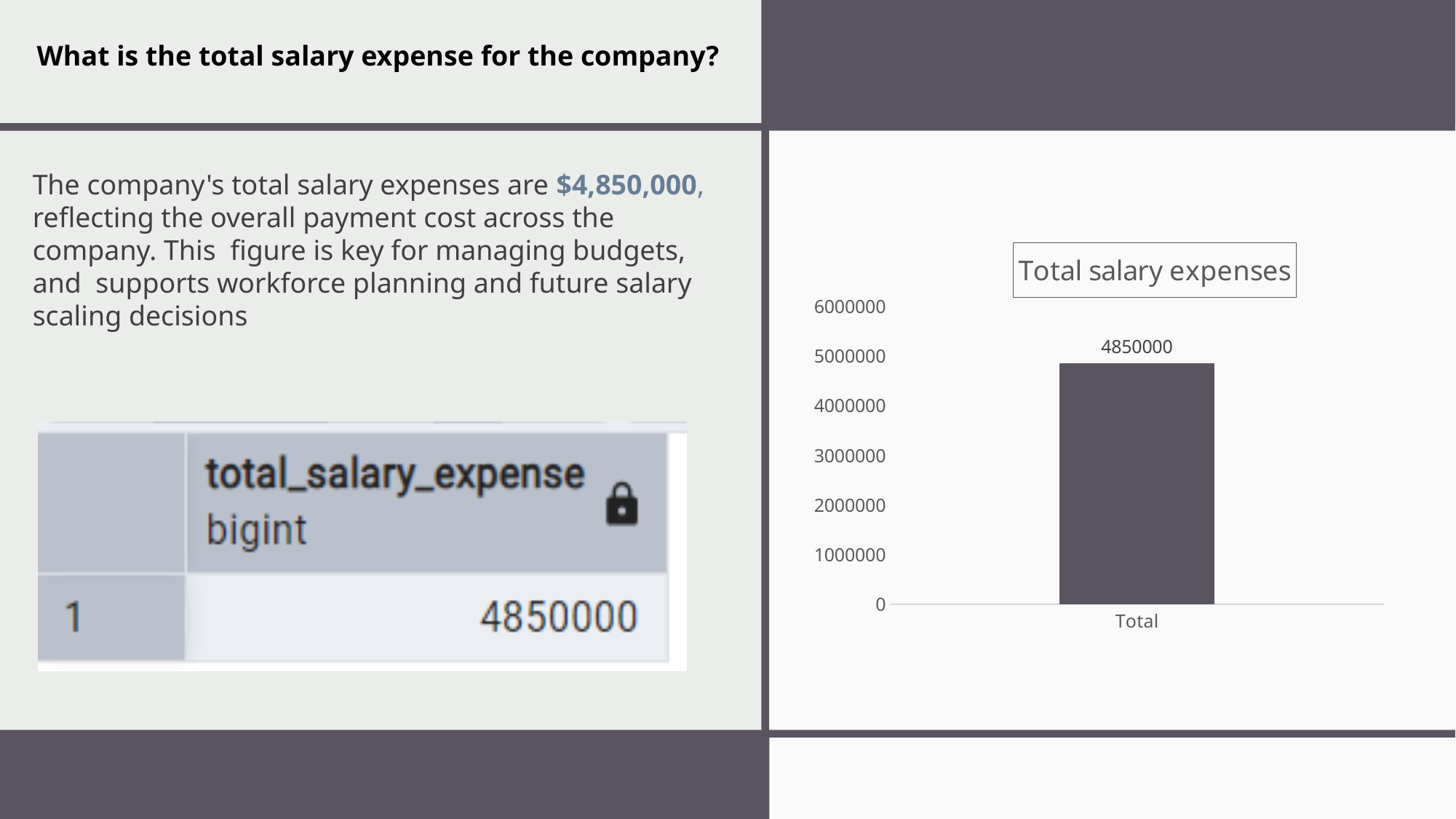
Is the value for Total greater or less than 4000000? greater What is the highest value shown on the chart's vertical axis? 6000000 What is the title of the chart? Total salary expenses What kind of chart is shown on the slide? bar chart What is the label of the category on the x axis of the chart? Total How many bars does the chart have? 1 Is the value for Total greater or less than 5000000? less What is the value of the Total bar in the chart? 4850000